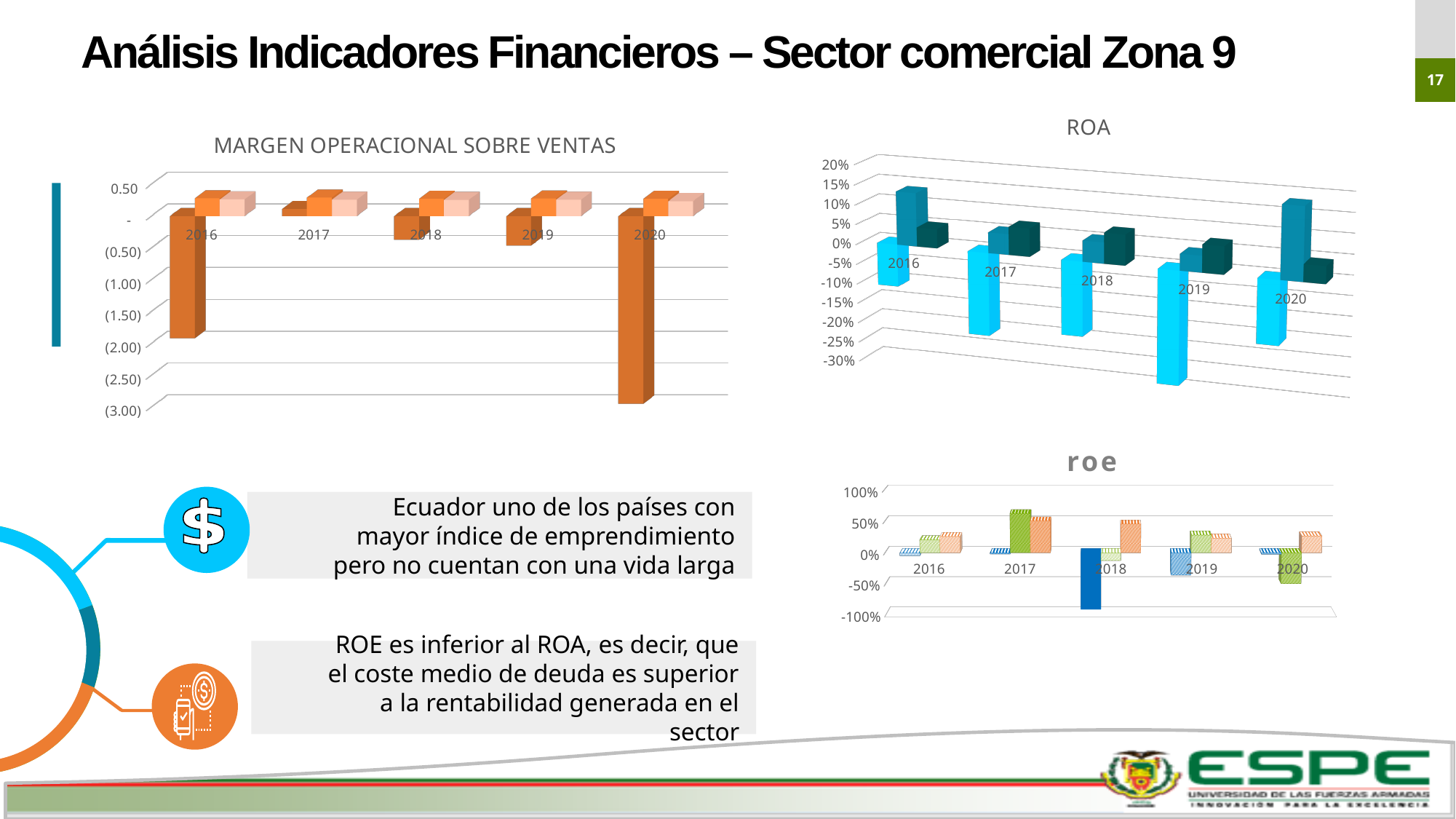
In the 'MARGEN OPERACIONAL SOBRE VENTAS' chart, which year has the lowest value for the first (dark orange) series? 2020 In the 'MARGEN OPERACIONAL SOBRE VENTAS' chart, is the first (dark orange) bar for 2020 greater or less than (2.00)? less How many charts are shown on the slide? 3 What kind of chart is the 'ROA' chart? bar chart In the 'roe' chart, is the first (dark blue) bar for 2018 greater or less than -50%? less In the 'ROA' chart, which is lower for the first (light blue) series: 2016 or 2019? 2019 In the 'ROA' chart, is the first (light blue) bar for 2019 greater or less than -20%? less What kind of chart is the 'MARGEN OPERACIONAL SOBRE VENTAS' chart? bar chart In the 'ROA' chart, which year has the lowest value for the first (light blue) series? 2019 How many years are shown on the x axis of the 'MARGEN OPERACIONAL SOBRE VENTAS' chart? 5 How many years are shown on the x axis of the 'roe' chart? 5